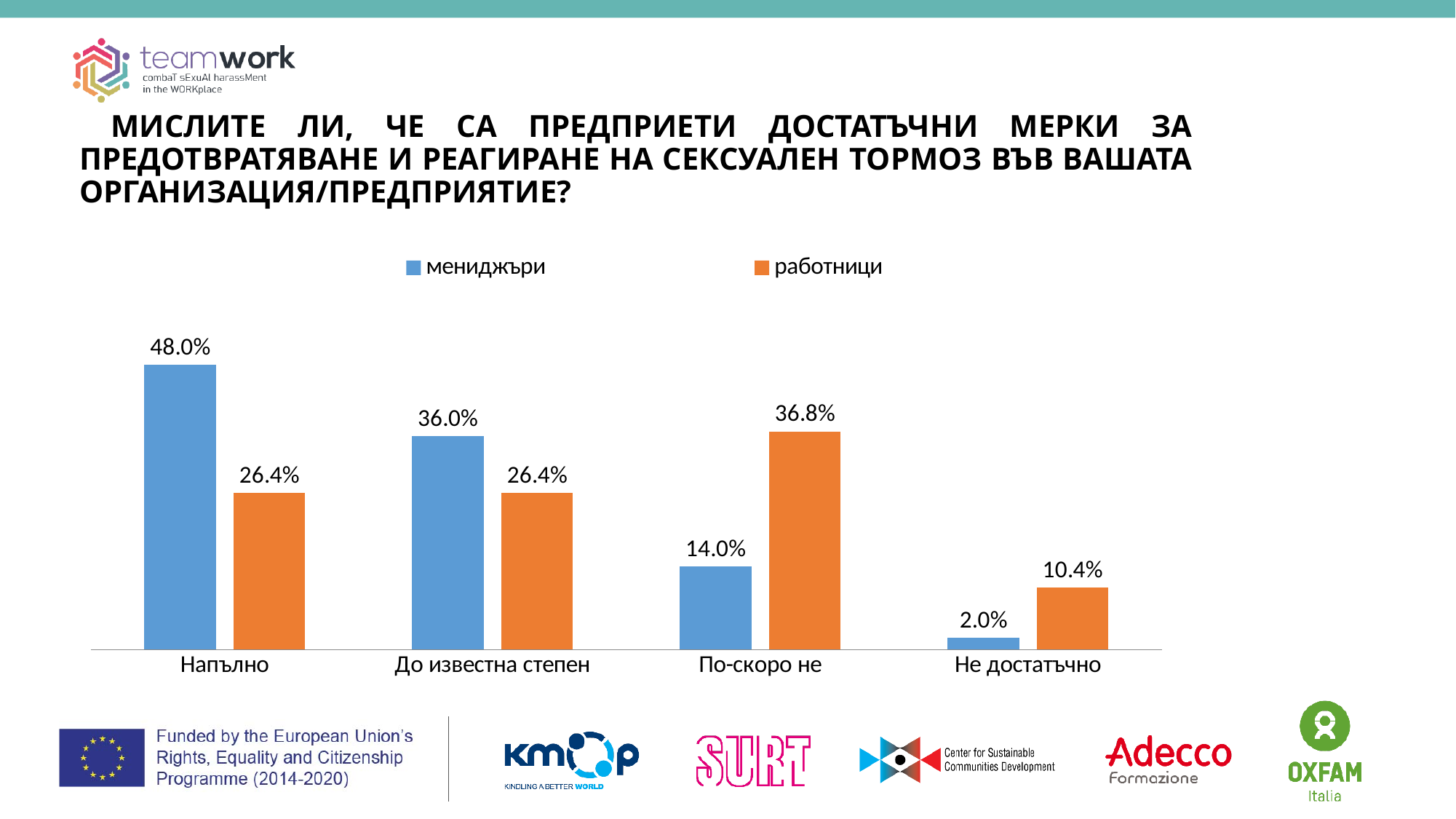
How many categories are shown on the x axis? 4 Which category has the lowest value for работници? Не достатъчно What is the difference between the мениджъри and работници values in the Напълно category? 21.6% What is the value for мениджъри in the Напълно category? 48.0% What kind of chart is shown on the slide? bar chart How many series does the legend list? 2 Which category has the highest value for мениджъри? Напълно In the По-скоро не category, which series has the larger value, мениджъри or работници? работници What is the value for работници in the Не достатъчно category? 10.4% Which colour represents the работници series? orange What is the value for работници in the По-скоро не category? 36.8% What is the value for мениджъри in the Не достатъчно category? 2.0%